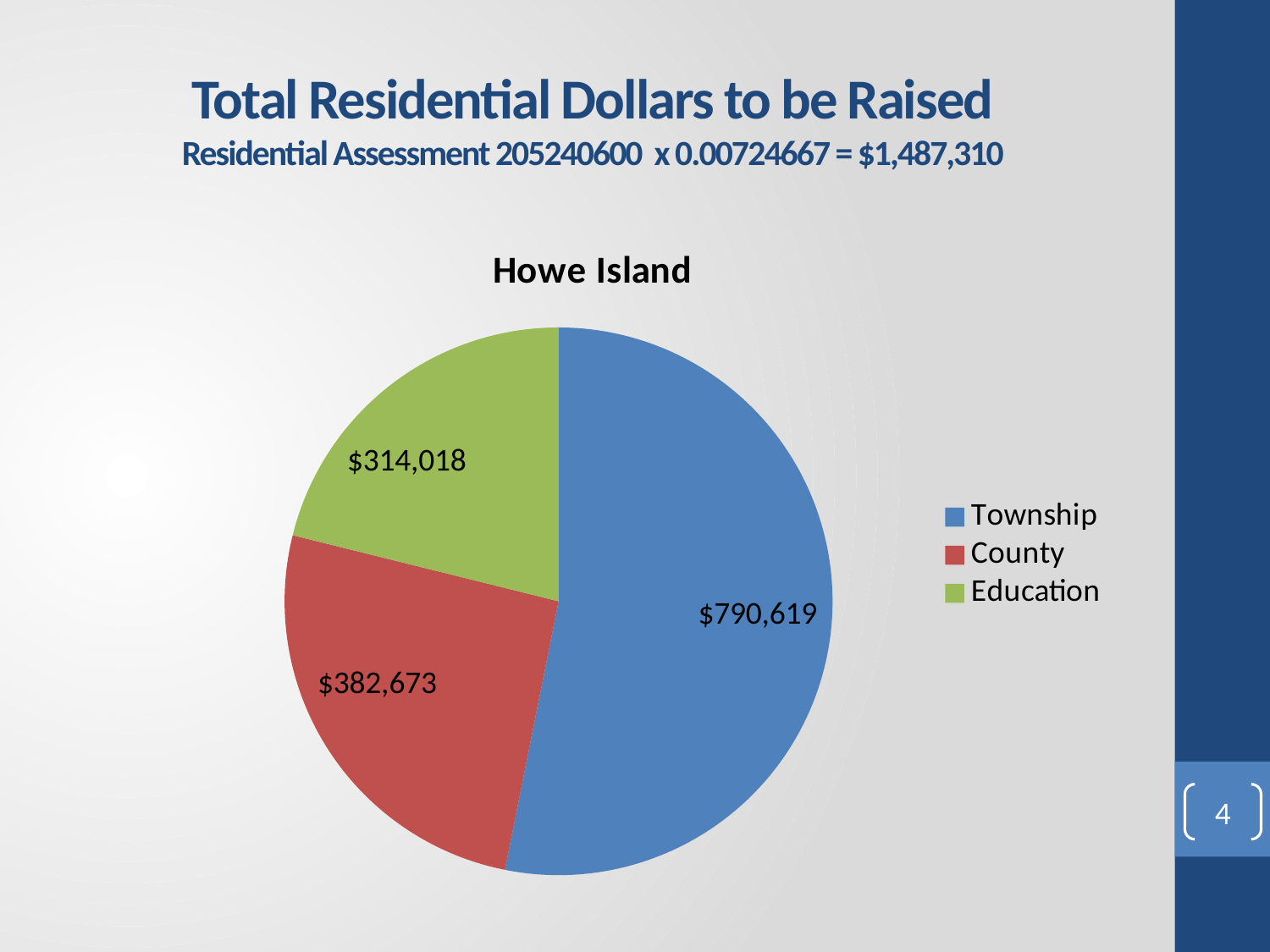
What is the title of the chart? Howe Island What is the value for County in the Howe Island pie chart? $382,673 What is the value for Township in the Howe Island pie chart? $790,619 What is the value for Education in the Howe Island pie chart? $314,018 How many slices does the pie chart have? 3 What type of chart is shown on the slide? pie chart How many categories does the legend list? 3 Which category has the largest slice in the pie chart? Township What is the difference between the Township value and the County value? $407,946 What is the difference between the County value and the Education value? $68,655 Which category has the smallest slice in the pie chart? Education Which is larger, the County slice or the Education slice? County